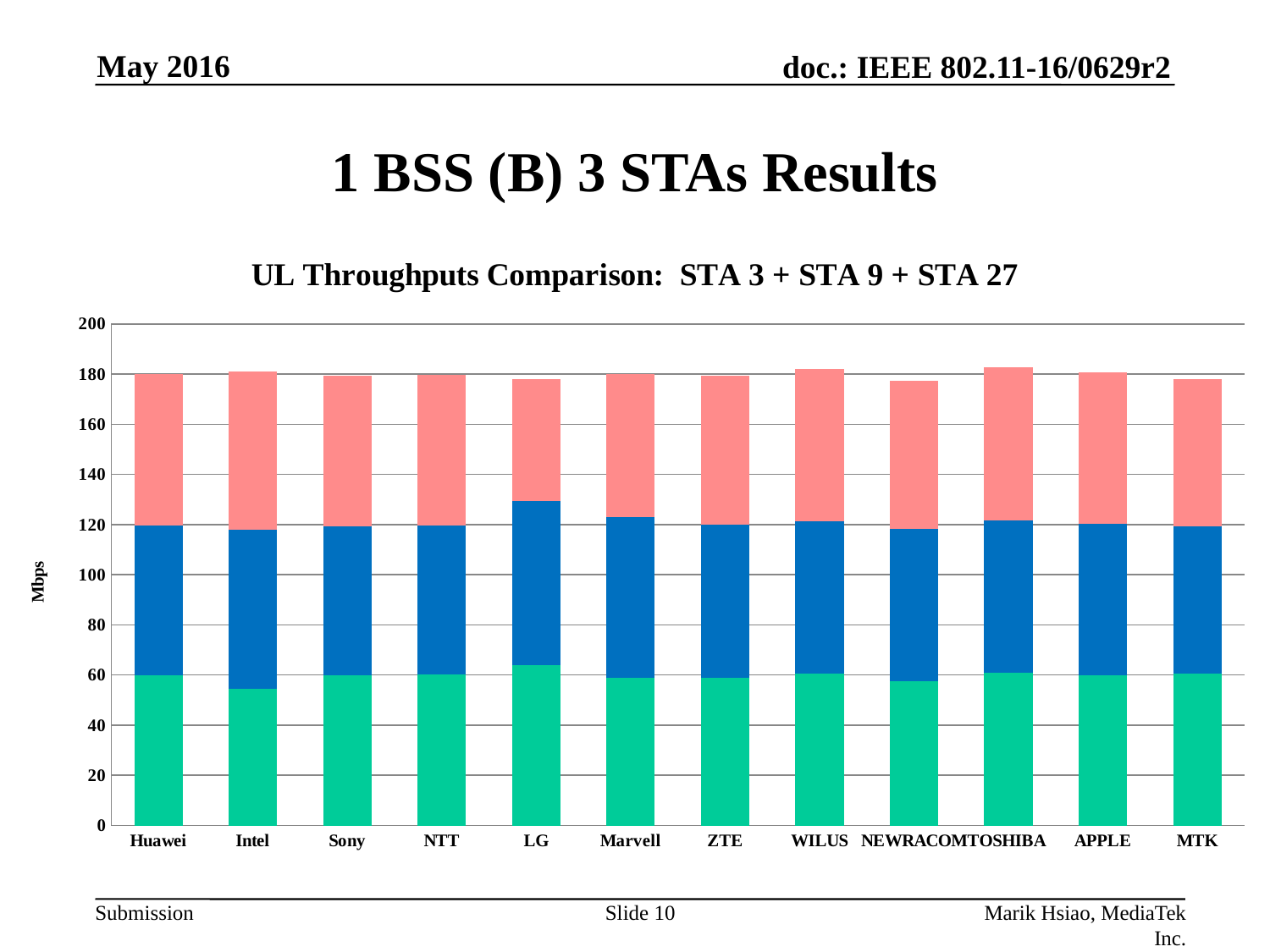
Is the total stacked value for MTK greater or less than 140? greater Which company has the shortest bottom (green) segment? Intel What unit is shown on the y axis label of the chart? Mbps Is the total stacked value for Huawei greater or less than 160? greater What kind of chart is shown on the slide? stacked bar chart What is the title of the chart? UL Throughputs Comparison: STA 3 + STA 9 + STA 27 Is the bottom (green) segment for LG greater or less than 60? greater Which company has the tallest bottom (green) segment? LG How many companies are shown along the x axis of the chart? 12 Is the bottom (green) segment for LG larger or smaller than the bottom (green) segment for Intel? larger